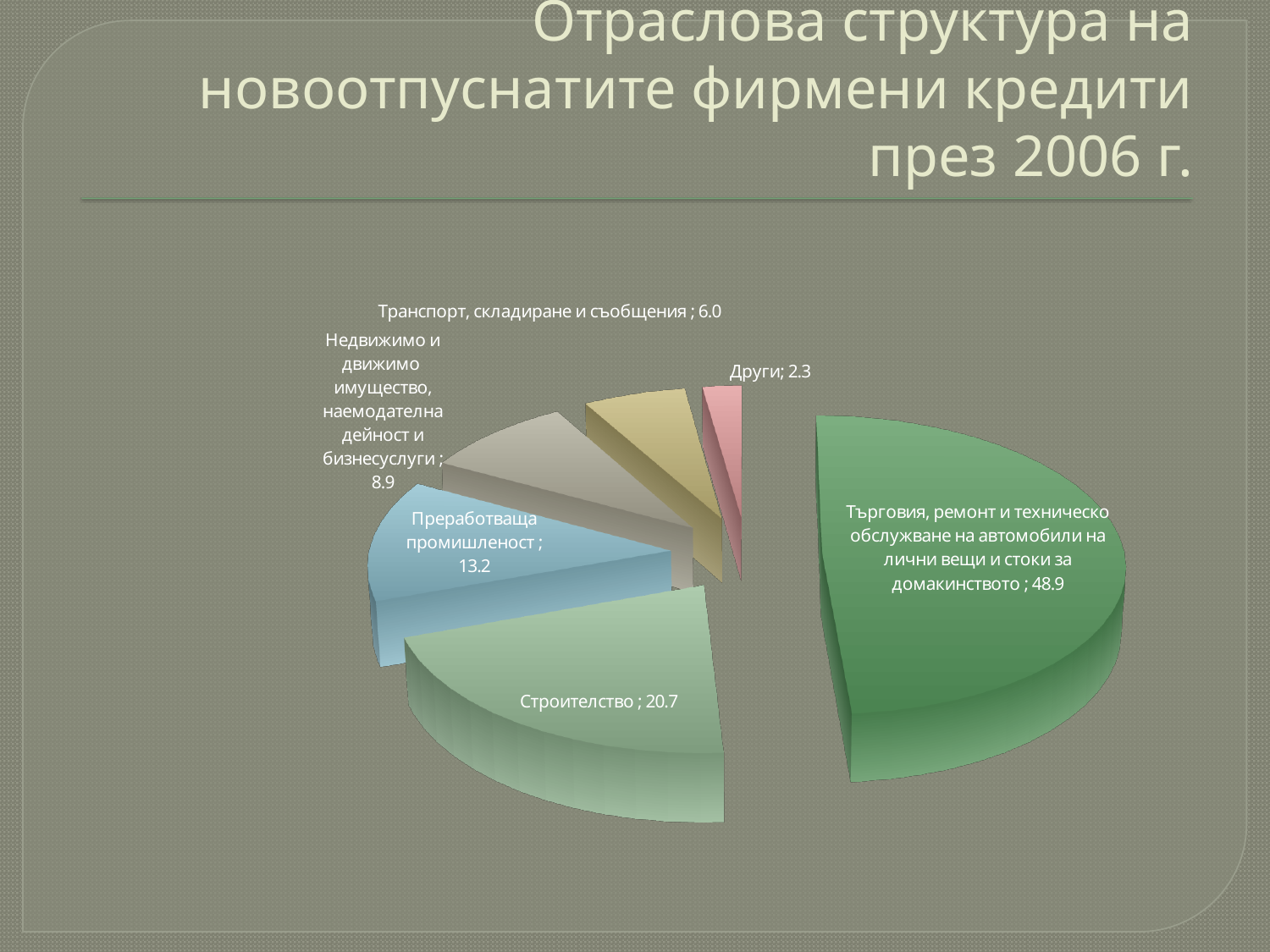
Which category has the smallest slice of the pie? Други What is the difference between the values for Търговия, ремонт и техническо обслужване на автомобили на лични вещи и стоки за домакинството and Строителство? 28.2 What is the value for Строителство? 20.7 What is the title of the chart on the slide? Отраслова структура на новоотпуснатите фирмени кредити през 2006 г. What is the difference between the values for Строителство and Преработваща промишленост? 7.5 What is the value for Преработваща промишленост? 13.2 Which category has the largest slice of the pie? Търговия, ремонт и техническо обслужване на автомобили на лични вещи и стоки за домакинството What is the value for Транспорт, складиране и съобщения? 6.0 What is the value for Други? 2.3 What kind of chart is shown on the slide? pie chart How many slices does the pie chart have? 6 Which is larger, the value for Недвижимо и движимо имущество, наемодателна дейност и бизнесуслуги or the value for Транспорт, складиране и съобщения? Недвижимо и движимо имущество, наемодателна дейност и бизнесуслуги